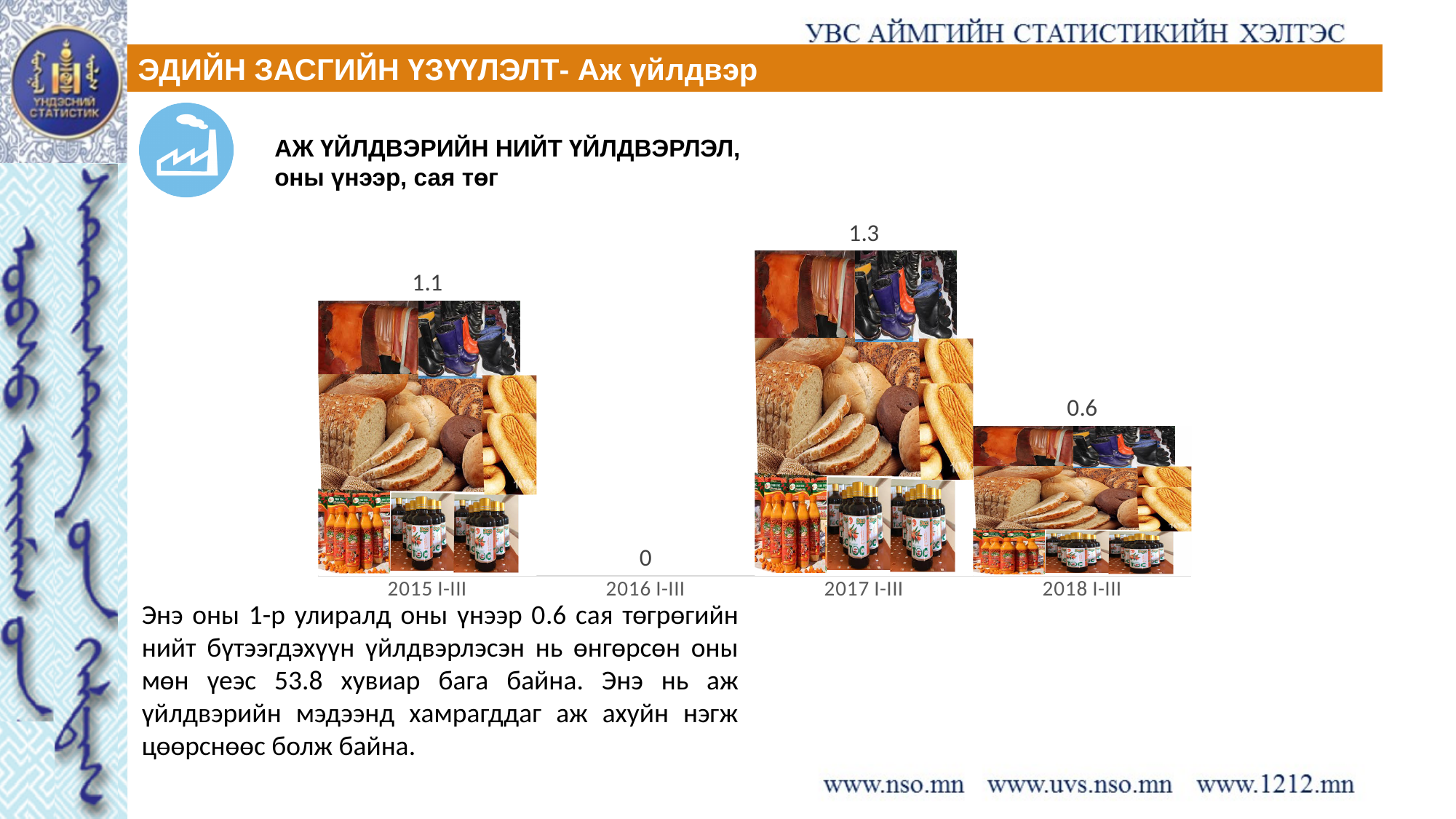
What kind of chart is shown on the slide? Bar chart How many periods are shown on the x axis of the chart? 4 What is the difference between the values for 2017 I-III and 2018 I-III? 0.7 What is the difference between the values for 2017 I-III and 2015 I-III? 0.2 What is the value for 2015 I-III? 1.1 What is the value for 2018 I-III? 0.6 Which period has the highest value? 2017 I-III What is the value for 2017 I-III? 1.3 Does the value rise or fall from 2017 I-III to 2018 I-III? Fall What is the value for 2016 I-III? 0 Which period has the lowest value? 2016 I-III Which is larger, the value for 2015 I-III or the value for 2018 I-III? 2015 I-III